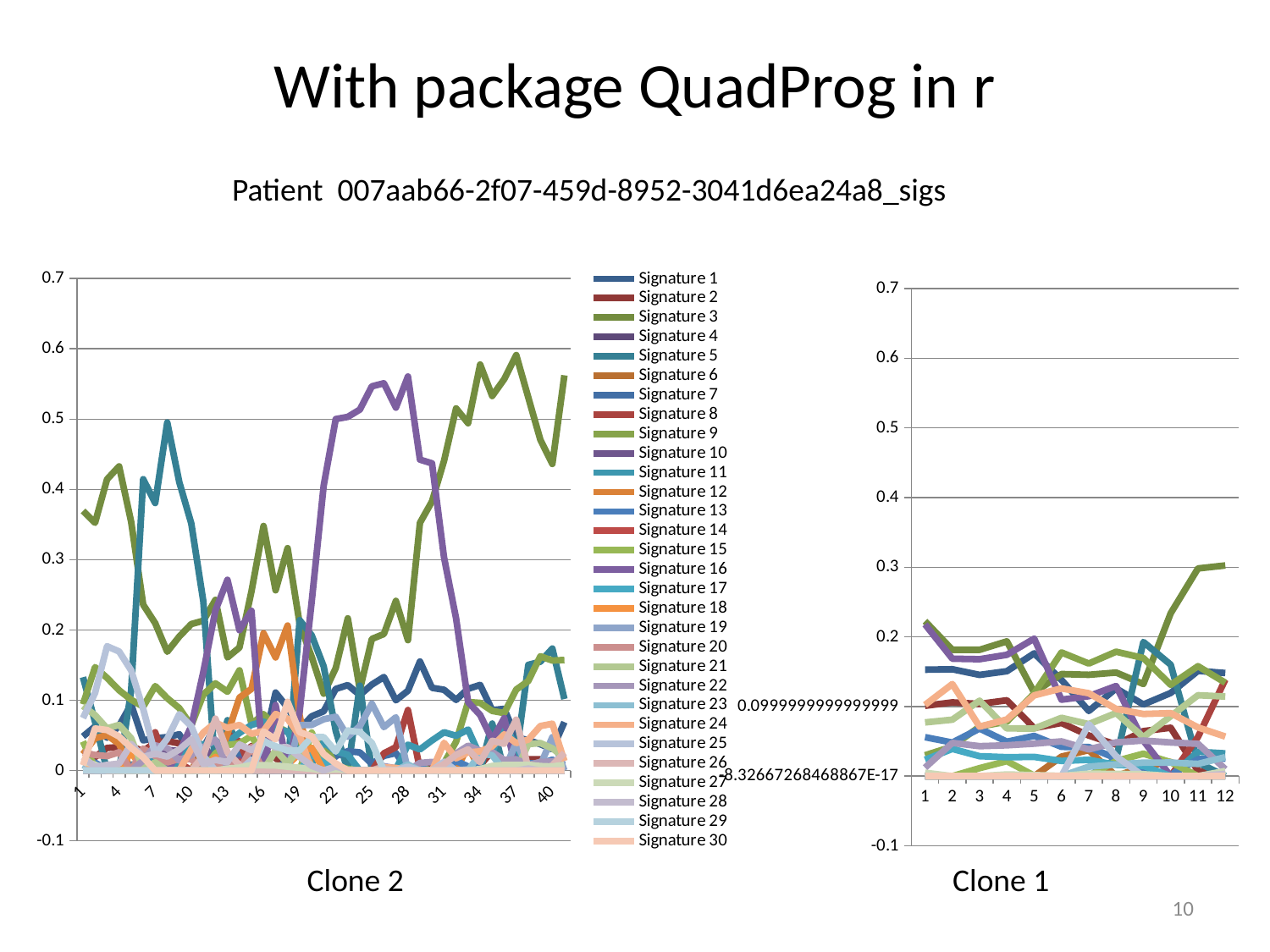
What kind of chart is the Clone 2 chart? line chart How many points are on the x axis of the Clone 1 chart? 12 How many series does the legend list? 30 In the Clone 1 chart, is the highest plotted value greater or less than 0.4? less In the Clone 2 chart, is the highest plotted value greater or less than 0.5? greater What kind of chart is the Clone 1 chart? line chart Which chart reaches a higher maximum value, Clone 2 or Clone 1? Clone 2 What is the label of the last series in the legend? Signature 30 What is the label of the first series in the legend? Signature 1